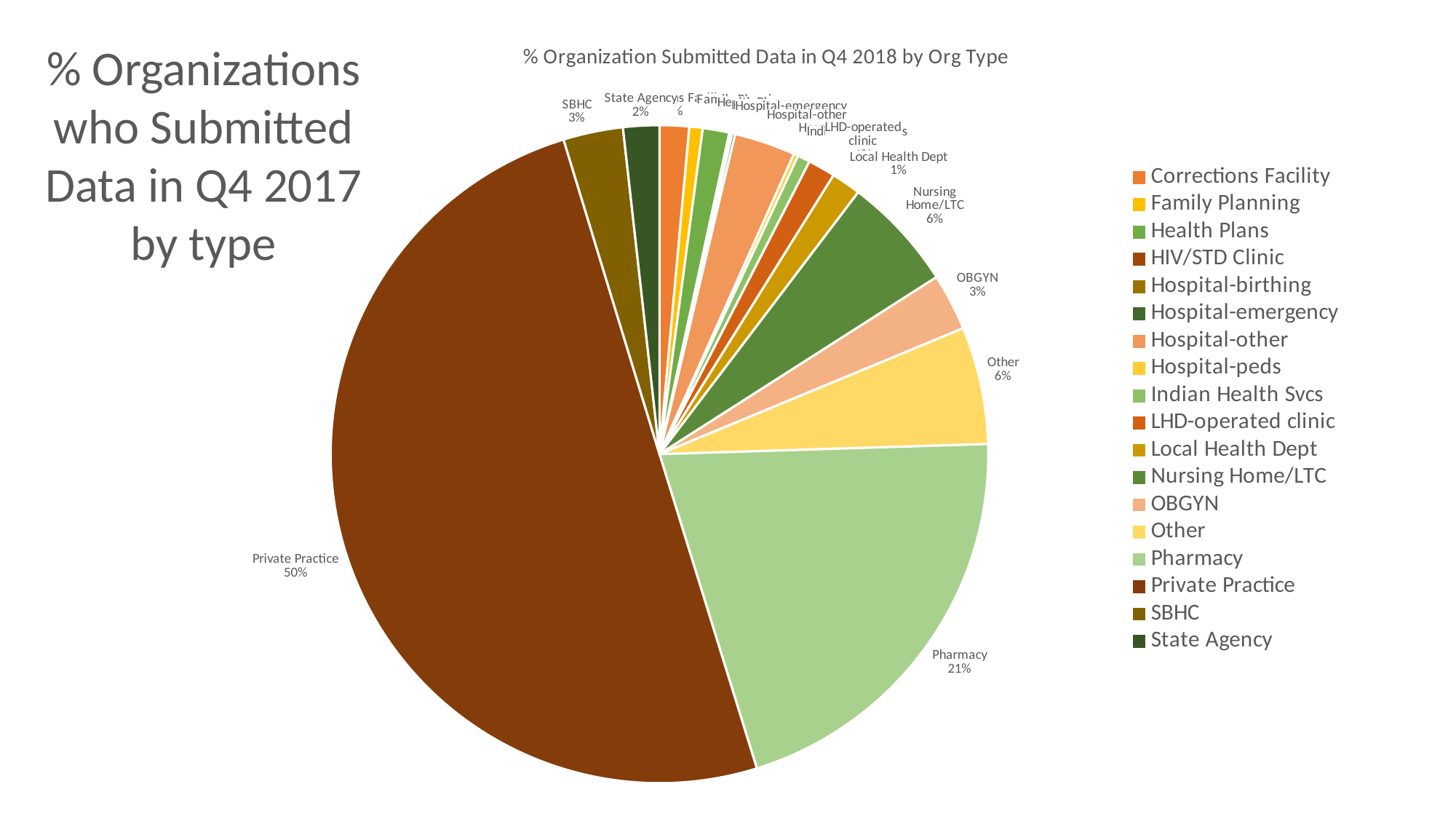
What is the value shown for OBGYN? 3% What is the value shown for Nursing Home/LTC? 6% What kind of chart is shown on the slide? pie chart What share of the pie does Pharmacy hold? 21% What share of the pie does Private Practice hold? 50% Which organization type has the largest slice of the pie? Private Practice What is the difference between the Private Practice share and the Pharmacy share? 29% What is the chart's title? % Organization Submitted Data in Q4 2018 by Org Type Which is larger, the share for Other or the share for OBGYN? Other What is the value shown for SBHC? 3% How many organization types does the legend list? 18 What is the value shown for State Agency? 2%